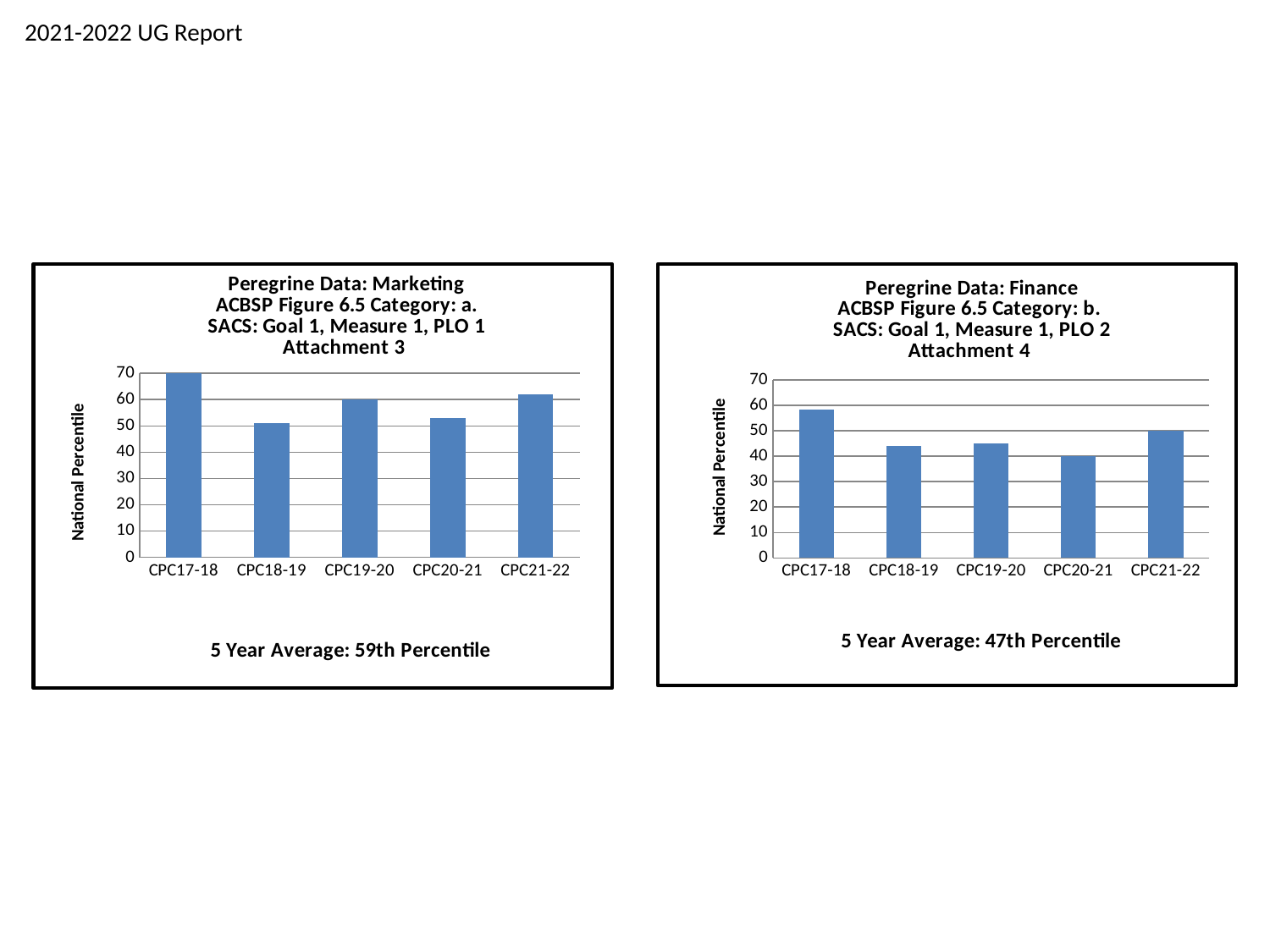
In the Peregrine Data: Marketing chart, which category has the highest national percentile? CPC17-18 What is the y-axis label on the Peregrine Data: Marketing chart? National Percentile In the Peregrine Data: Finance chart, which category has the lowest national percentile? CPC20-21 In the Peregrine Data: Finance chart, which category has the highest national percentile? CPC17-18 What 5 year average is stated below the Peregrine Data: Finance chart? 47th Percentile What kind of chart is the Peregrine Data: Marketing chart? bar chart In the Peregrine Data: Marketing chart, is the value for CPC21-22 greater or less than 60? greater In the Peregrine Data: Finance chart, what is the national percentile for CPC20-21? 40 In the Peregrine Data: Marketing chart, which is larger, the value for CPC17-18 or the value for CPC18-19? CPC17-18 How many categories are shown on the x axis of the Peregrine Data: Finance chart? 5 In the Peregrine Data: Finance chart, is the value for CPC18-19 greater or less than 50? less